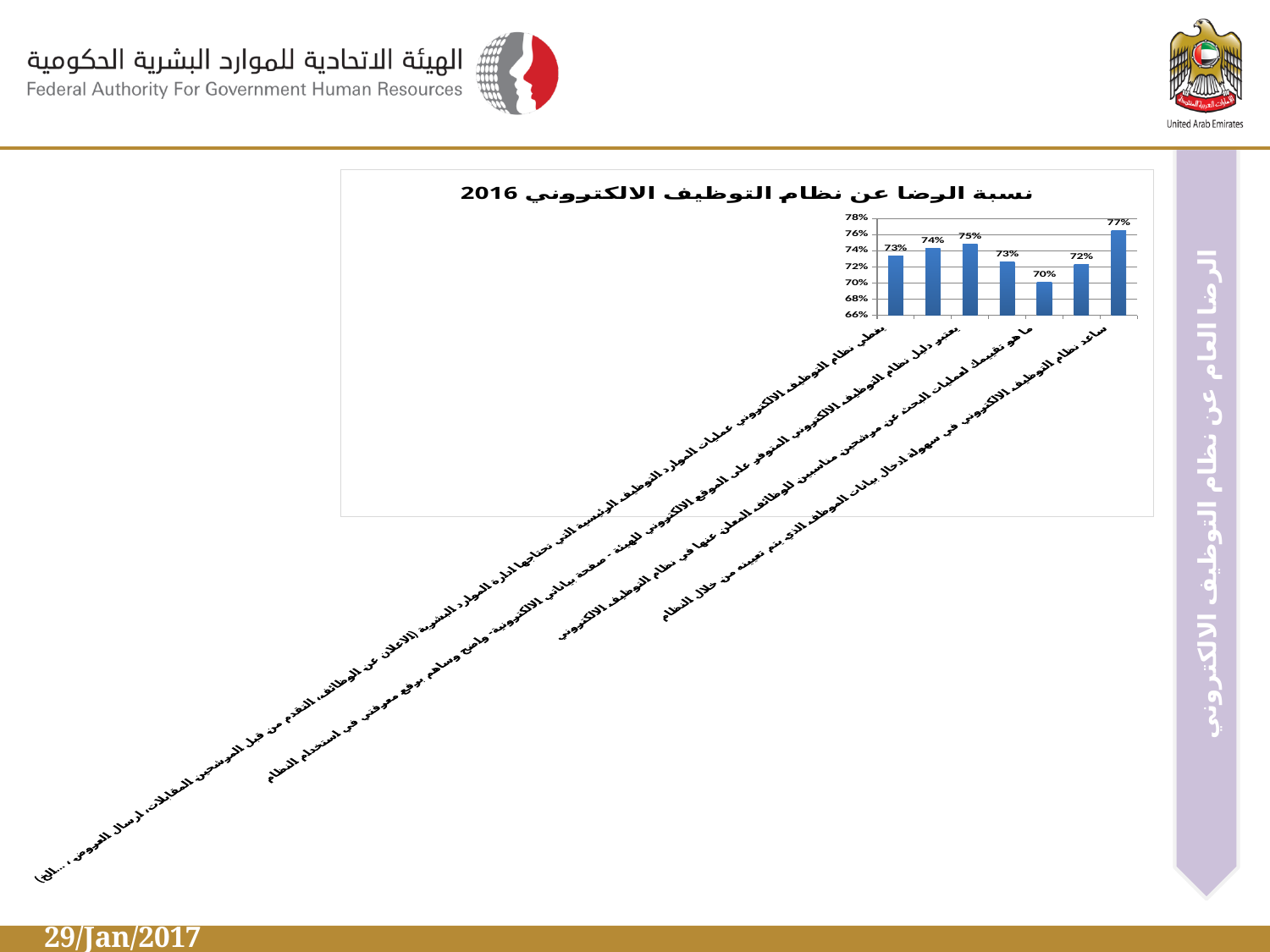
What is the difference between the highest and lowest values in the chart? 7% What is the value of the third bar from the left in the chart? 75% What is the difference between the rightmost bar and the leftmost bar? 4% What is the lowest value shown in the chart? 70% Is the value of the fifth bar from the left greater or less than 72%? less How many bars are plotted in the chart? 7 What is the highest value shown in the chart? 77% What is the value of the last (rightmost) bar in the chart? 77% What is the value of the first (leftmost) bar in the chart? 73% Which is larger, the value of the second bar from the left or the value of the fifth bar from the left? the second bar (74%) What is the title of the chart? نسبة الرضا عن نظام التوظيف الالكتروني 2016 What type of chart is shown on the slide? bar chart